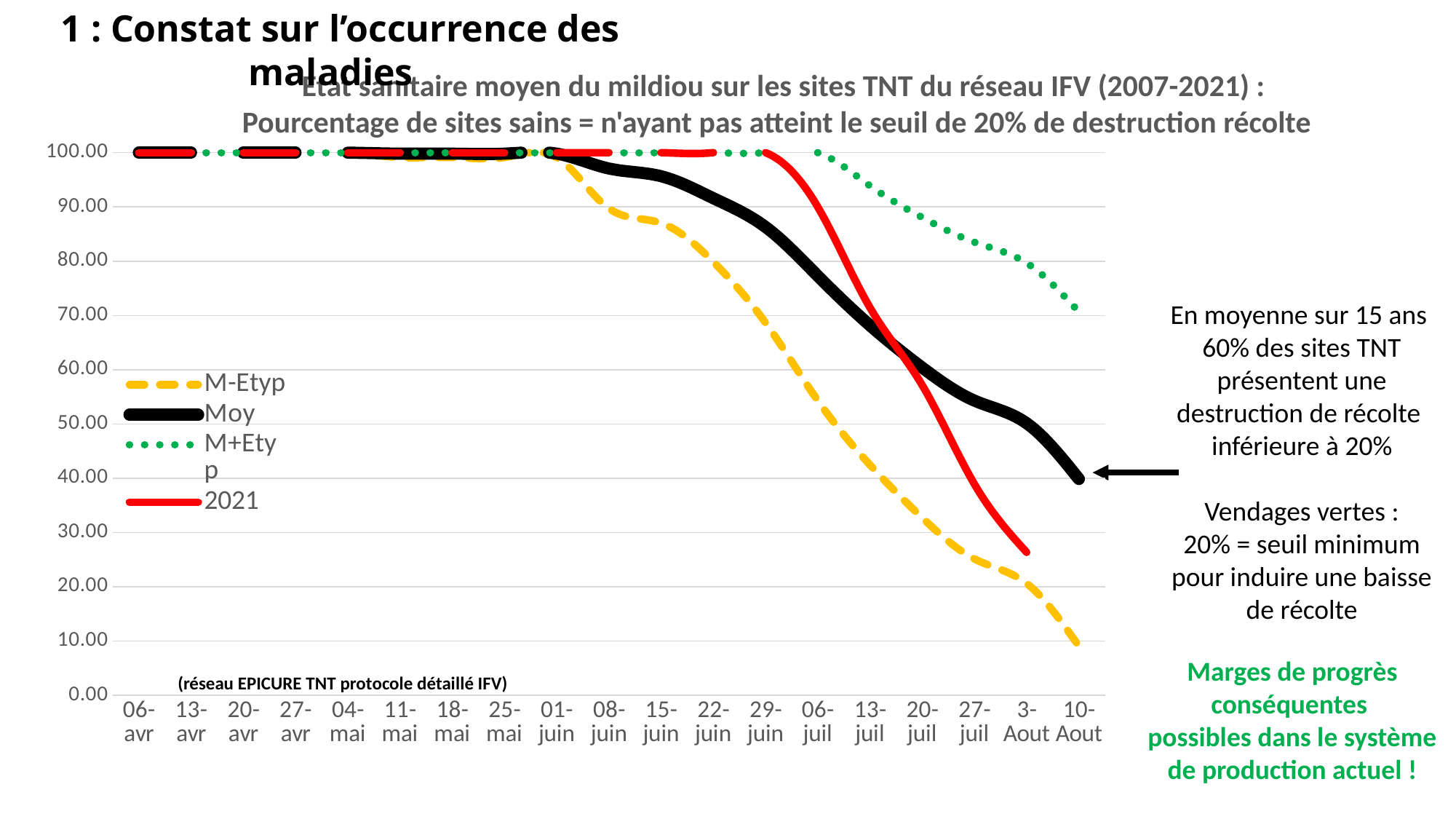
How many series does the chart legend list? 4 What kind of chart is shown on the slide? line chart Do the values of the Moy series rise or fall along the x axis? fall How many dates are shown along the x axis of the chart? 19 What colour is the line for the 2021 series? red What is the value of the Moy series at 06-avr? 100.00 Which series has the lowest value at 10-Aout? M-Etyp Is the value of the Moy series at 10-Aout greater or less than 50.00? less Is the value of the M-Etyp series at 10-Aout greater or less than 20.00? less At 10-Aout, which series has the higher value, M+Etyp or M-Etyp? M+Etyp Is the value of the 2021 series at 3-Aout greater or less than 30.00? less